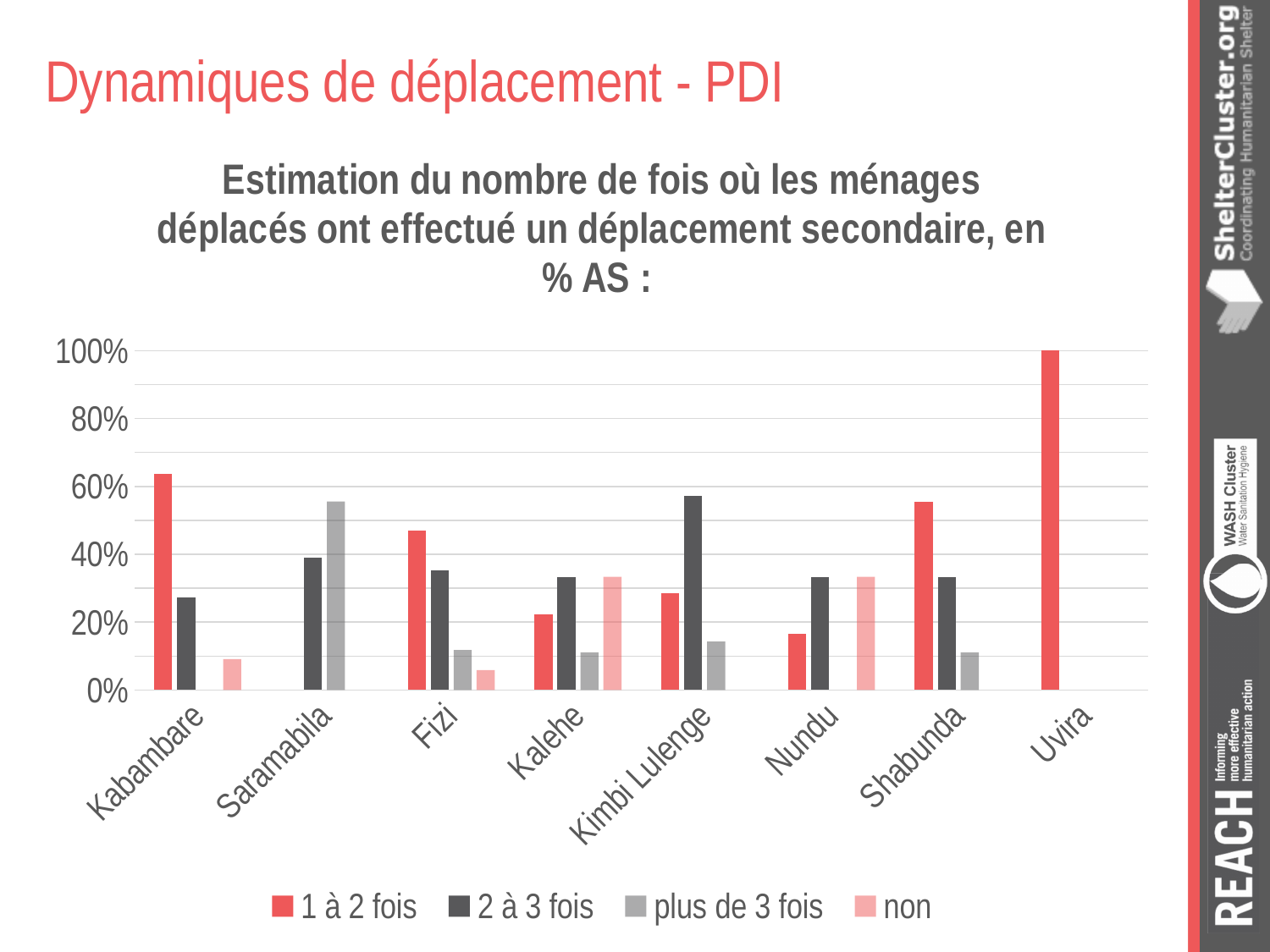
Is the value for 'plus de 3 fois' in Saramabila greater or less than 40%? greater In Kimbi Lulenge, which is larger: '1 à 2 fois' or '2 à 3 fois'? 2 à 3 fois Is the value for '1 à 2 fois' in Nundu greater or less than 20%? less Is the value for '1 à 2 fois' in Fizi greater or less than 40%? greater What kind of chart is shown on the slide? bar chart How many series does the legend of the chart list? 4 Which series is shown in red in the chart? 1 à 2 fois Which is larger: the '1 à 2 fois' value for Shabunda or for Kalehe? Shabunda What is the value for '1 à 2 fois' in Uvira? 100% How many categories (zones) are shown on the x axis of the chart? 8 Which zone has the highest value for '1 à 2 fois'? Uvira